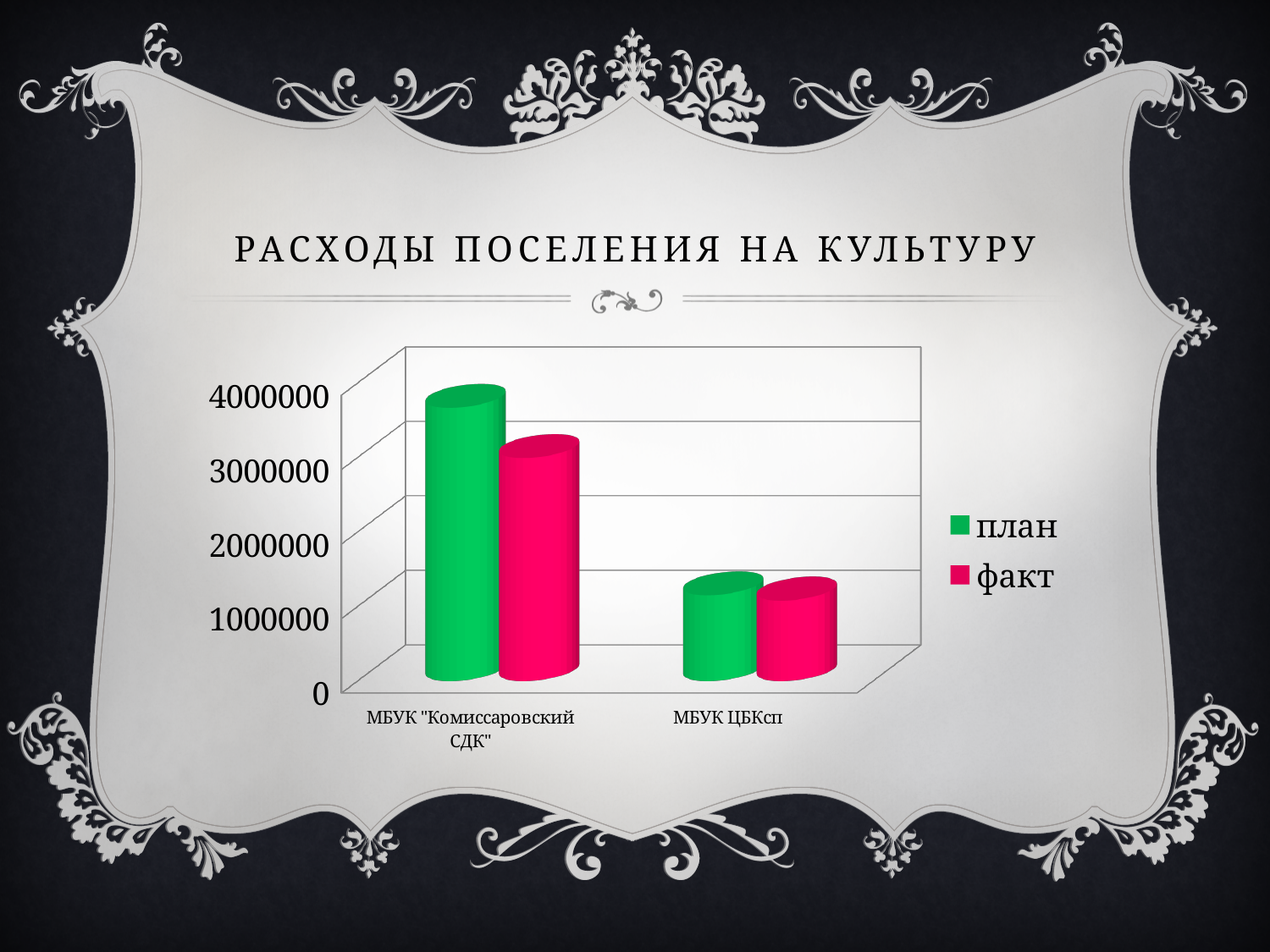
Which category has the lowest факт value? МБУК ЦБКсп Is the факт value for МБУК ЦБКсп greater or less than 3000000? less Is the план value for МБУК "Комиссаровский СДК" greater or less than 3000000? greater How many categories are shown on the x axis? 2 What kind of chart is shown on the slide? bar chart Is the факт value for МБУК "Комиссаровский СДК" greater or less than 2000000? greater Which category has the highest план value? МБУК "Комиссаровский СДК" For МБУК "Комиссаровский СДК", which is larger: план or факт? план How many series does the legend list? 2 Which series is shown in green? план What is the title of the chart? Расходы поселения на культуру